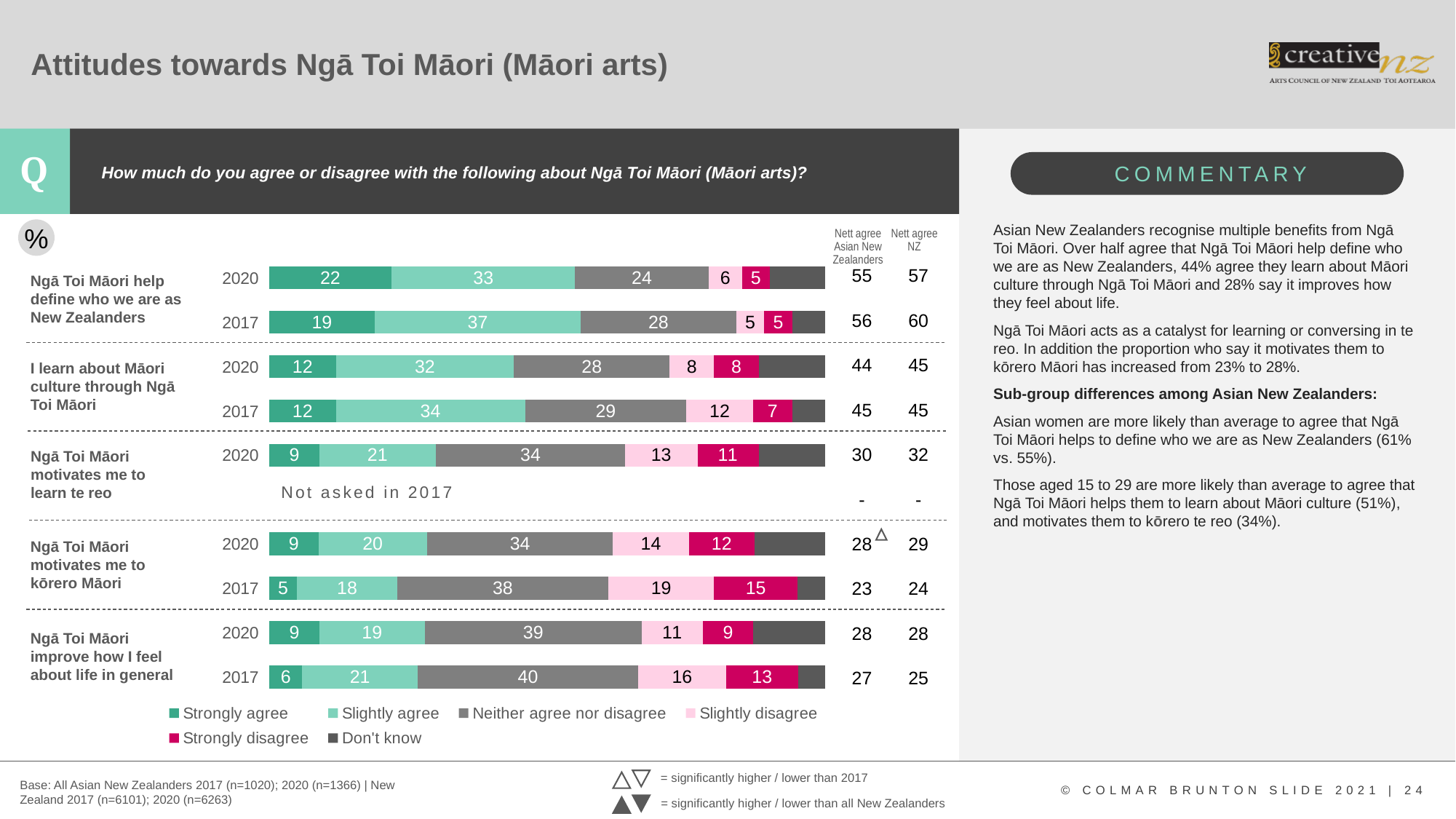
By how many percentage points did 'Strongly disagree' for 'Ngā Toi Māori motivates me to kōrero Māori' fall from 2017 to 2020? 3 Which statement has the highest 'Strongly agree' value in 2020? Ngā Toi Māori help define who we are as New Zealanders What is the Nett agree figure for Asian New Zealanders for 'Ngā Toi Māori motivates me to learn te reo' in 2020? 30 Which bar has the lowest 'Strongly agree' value on the chart? Ngā Toi Māori motivates me to kōrero Māori, 2017 Which statement was not asked in 2017? Ngā Toi Māori motivates me to learn te reo How many statements about Ngā Toi Māori are shown on the chart? 5 What is the 'Slightly disagree' value for 'I learn about Māori culture through Ngā Toi Māori' in 2017? 12 What percentage of Asian New Zealanders strongly agreed in 2020 that Ngā Toi Māori help define who we are as New Zealanders? 22 What kind of chart is shown on the slide? Stacked bar chart How many series does the chart legend list? 6 What is the 'Neither agree nor disagree' value for 'Ngā Toi Māori improve how I feel about life in general' in 2017? 40 For 'Ngā Toi Māori help define who we are as New Zealanders', was the 'Slightly agree' value higher in 2017 or 2020? 2017